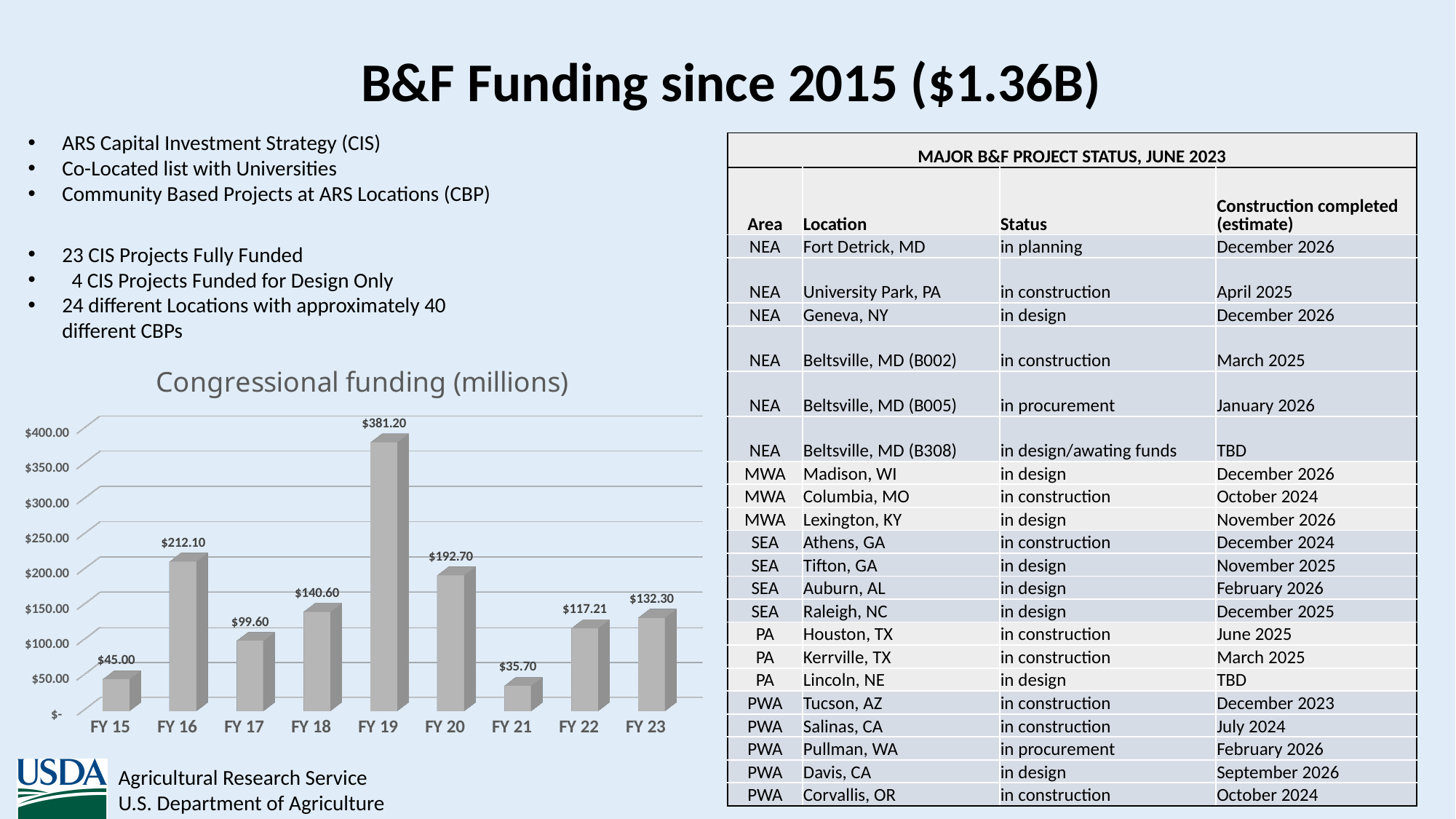
What is the title of the chart on the slide? Congressional funding (millions) In the Congressional funding (millions) chart, is the value for FY 21 greater or less than $50.00? less How many fiscal years are shown in the Congressional funding (millions) chart? 9 What is the value for FY 19 in the Congressional funding (millions) chart? $381.20 What kind of chart is the Congressional funding (millions) chart? bar chart In the Congressional funding (millions) chart, which is larger, the value for FY 18 or the value for FY 20? FY 20 What is the value for FY 15 in the Congressional funding (millions) chart? $45.00 Which fiscal year has the lowest value in the Congressional funding (millions) chart? FY 21 What is the difference between the FY 16 and FY 17 values in the Congressional funding (millions) chart? $112.50 What is the difference between the FY 23 and FY 22 values in the Congressional funding (millions) chart? $15.09 Which fiscal year has the highest value in the Congressional funding (millions) chart? FY 19 What is the value for FY 22 in the Congressional funding (millions) chart? $117.21